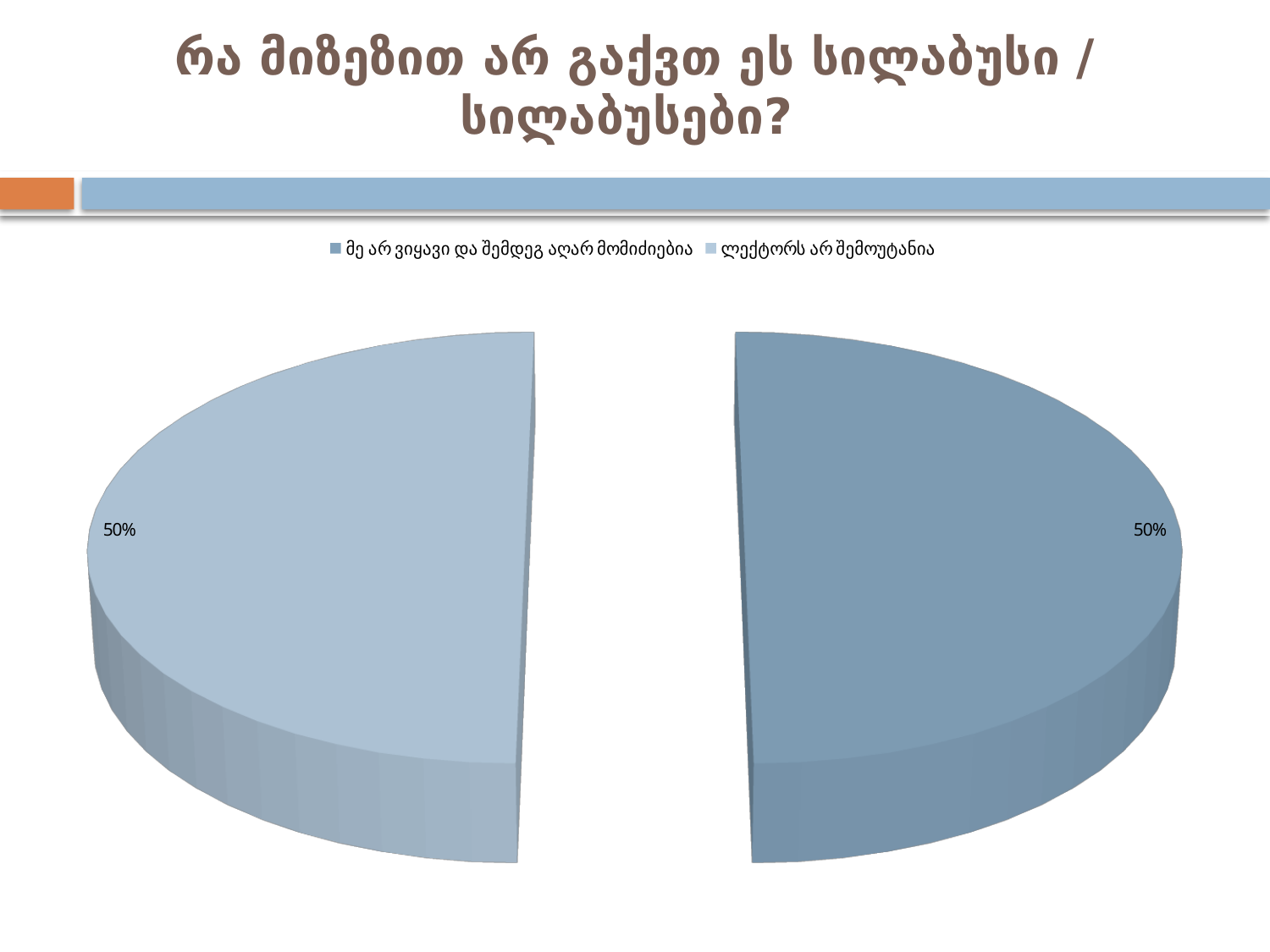
Do the two slices of the pie chart have equal shares? yes What is the title of the slide containing the chart? რა მიზეზით არ გაქვთ ეს სილაბუსი / სილაბუსები? What value is labelled on the light blue slice? 50% Which legend entry is shown in the lighter blue colour? ლექტორს არ შემოუტანია What kind of chart is shown on the slide? pie chart What share of the pie does "ლექტორს არ შემოუტანია" take? 50% What value is labelled on the dark blue slice? 50% What is the total of the two slice percentages shown? 100% What share of the pie does "მე არ ვიყავი და შემდეგ აღარ მომიძიება" take? 50% How many slices does the pie chart have? 2 How many entries does the legend list? 2